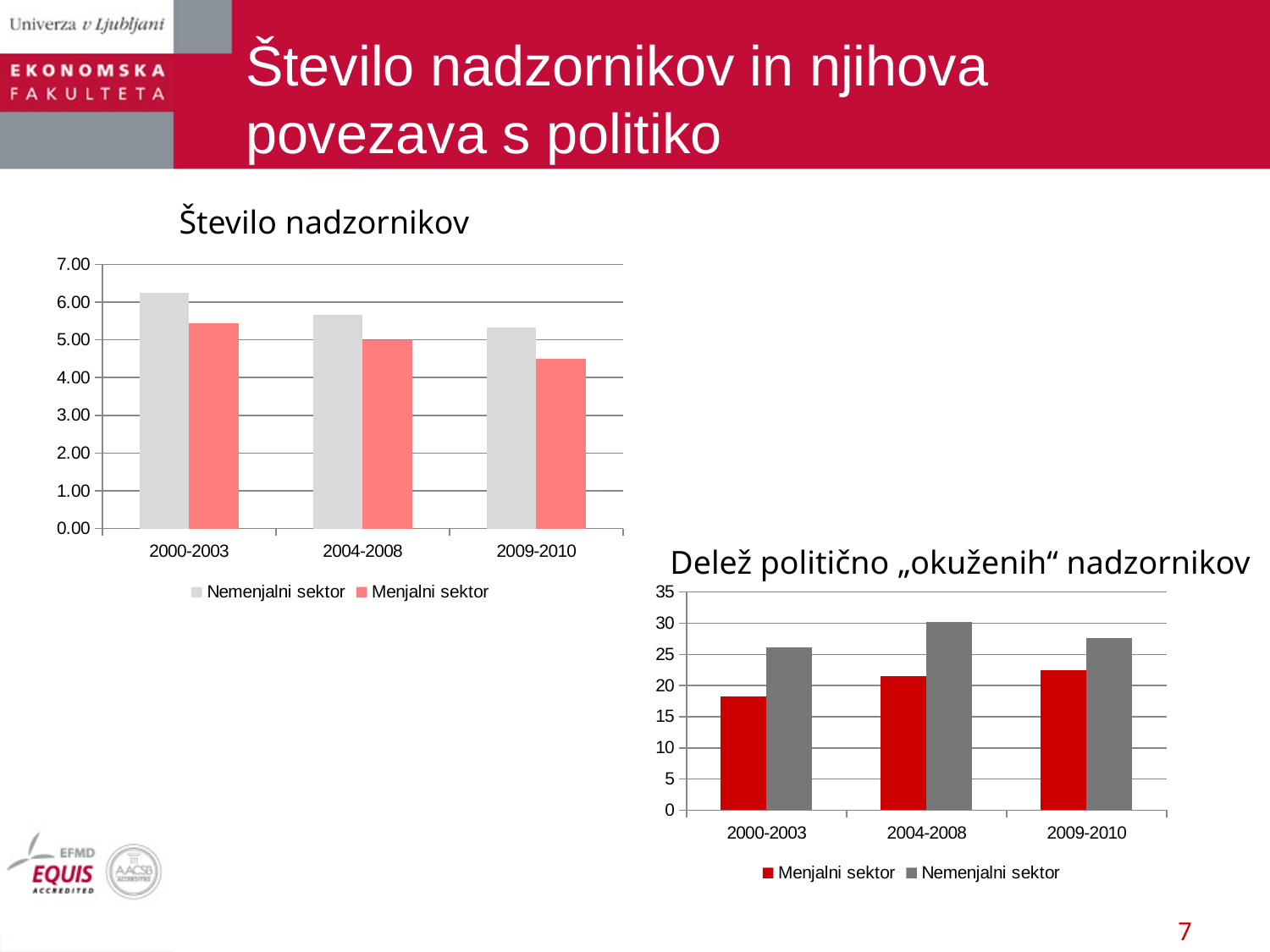
In the chart titled "Število nadzornikov", how many period categories are shown on the x axis? 3 In the chart titled "Delež politično „okuženih“ nadzornikov", how many series does the legend list? 2 In the chart titled "Število nadzornikov", what kind of chart is shown? bar chart In the chart titled "Število nadzornikov", do the values for Nemenjalni sektor rise or fall from 2000-2003 to 2009-2010? fall In the chart titled "Število nadzornikov", which series has the larger value in 2004-2008, Nemenjalni sektor or Menjalni sektor? Nemenjalni sektor In the chart titled "Število nadzornikov", how many series does the legend list? 2 In the chart titled "Delež politično „okuženih“ nadzornikov", in which period is the value for Nemenjalni sektor highest? 2004-2008 In the chart titled "Delež politično „okuženih“ nadzornikov", is the value for Menjalni sektor in 2000-2003 greater or less than 20? less In the chart titled "Delež politično „okuženih“ nadzornikov", in which period is the value for Menjalni sektor lowest? 2000-2003 In the chart titled "Število nadzornikov", is the value for Menjalni sektor in 2009-2010 greater or less than 5.00? less In the chart titled "Delež politično „okuženih“ nadzornikov", what colour are the bars for Menjalni sektor? red In the chart titled "Število nadzornikov", is the value for Nemenjalni sektor in 2000-2003 greater or less than 6.00? greater